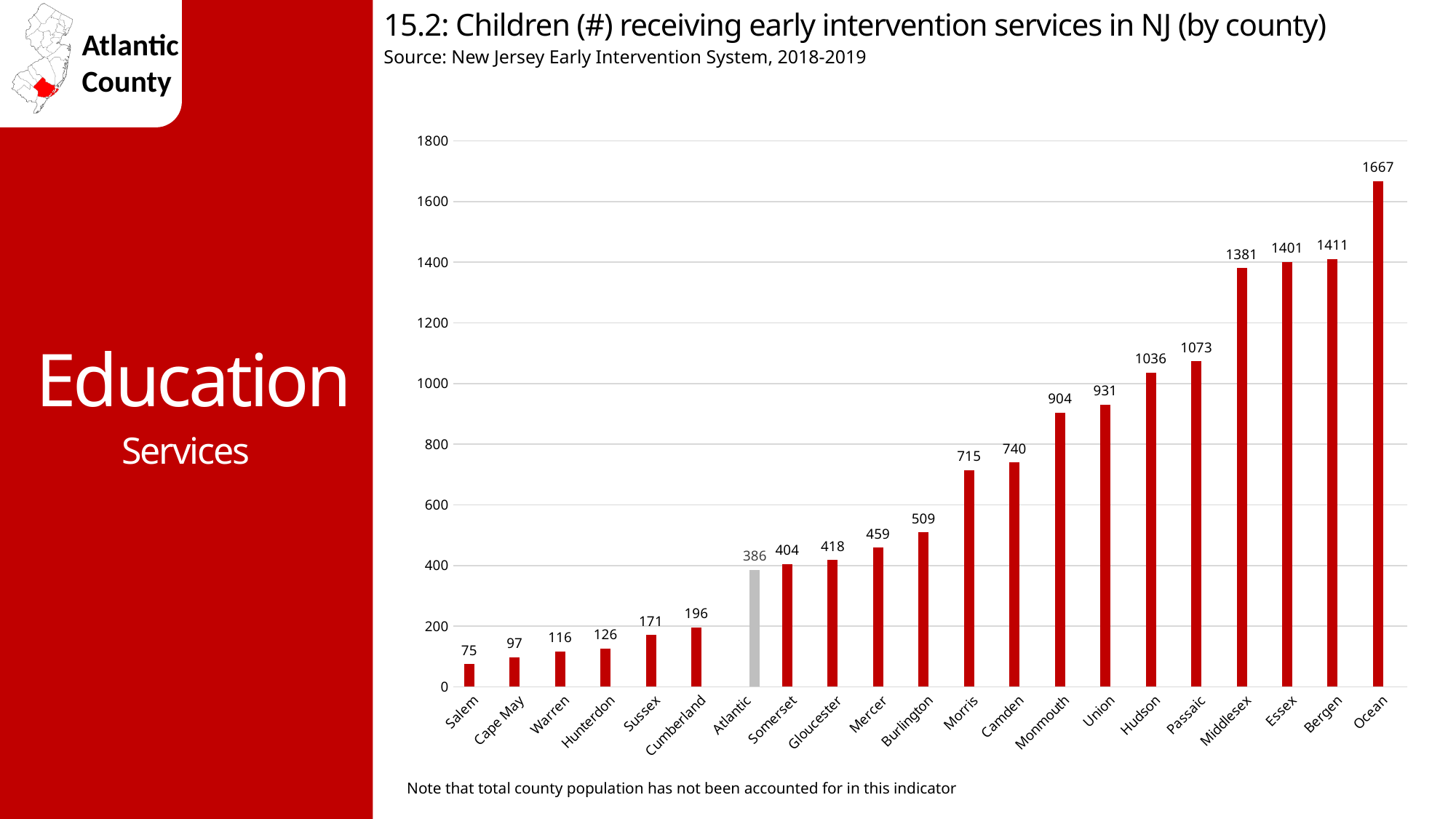
What is the value shown for Ocean County? 1667 How many counties are shown on the chart? 21 What is the value shown for Hudson County? 1036 Is the value for Passaic greater or less than 1000? greater Do the values rise or fall moving from left to right along the x axis? Rise How many children received early intervention services in Atlantic County? 386 Which county has a larger value, Morris or Camden? Camden What kind of chart is shown on the slide? Bar chart Which county has the lowest number of children receiving early intervention services? Salem What is the difference between the values for Bergen and Essex counties? 10 Which county has the highest number of children receiving early intervention services? Ocean What is the difference between the values for Ocean and Atlantic counties? 1281